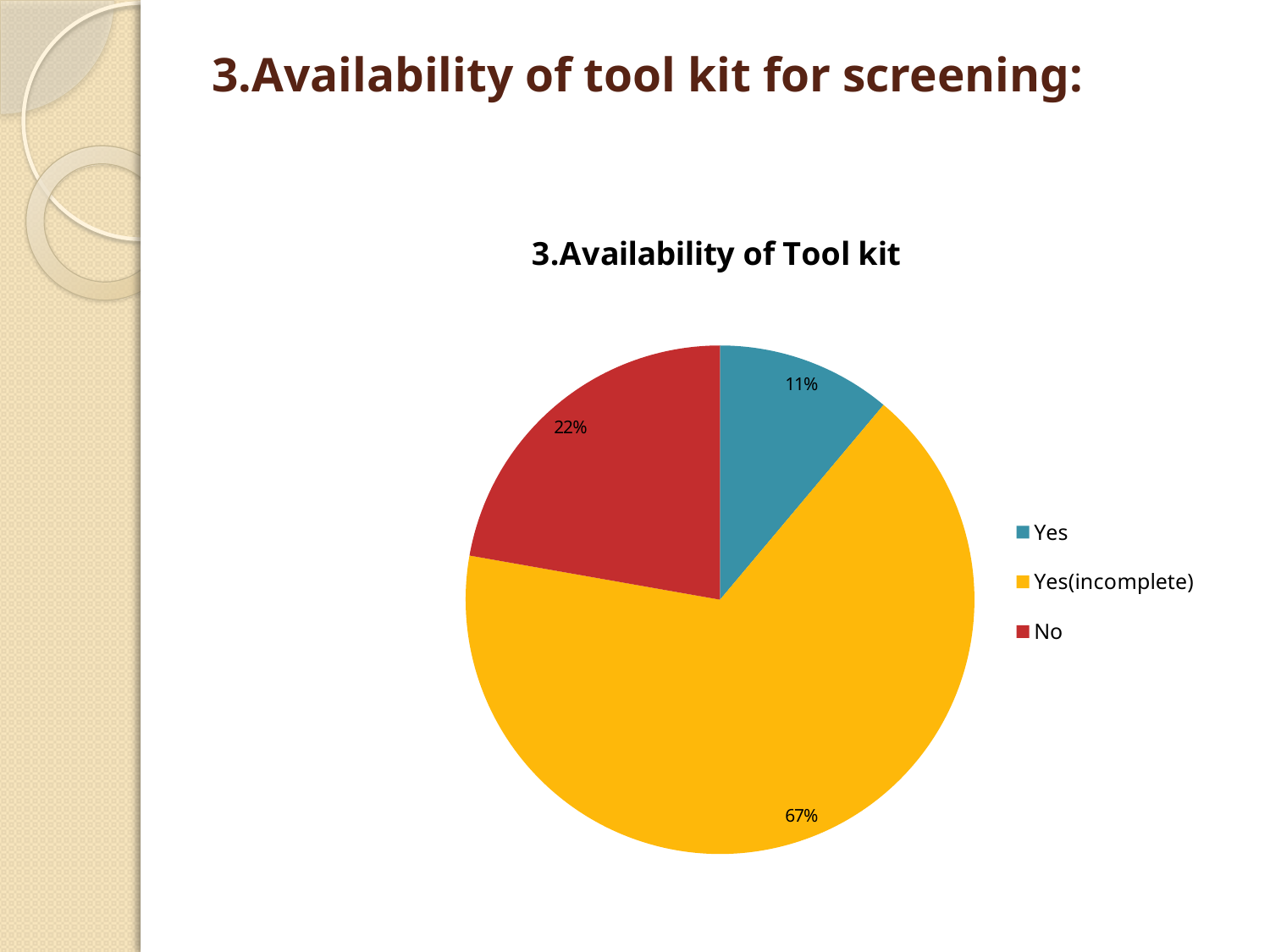
What is the difference in percentage points between the "Yes(incomplete)" slice and the "No" slice? 45 What is the title of the chart? 3.Availability of Tool kit What percentage of the pie is labelled "No"? 22% What kind of chart is shown on the slide? pie chart What percentage of the pie is labelled "Yes(incomplete)"? 67% How many slices does the pie chart have? 3 Which slice is larger, "No" or "Yes"? No What colour is the "No" slice in the pie chart? red Which category has the smallest share of the pie? Yes What percentage of the pie is labelled "Yes"? 11% Which category has the largest share of the pie? Yes(incomplete) How many entries does the legend list? 3